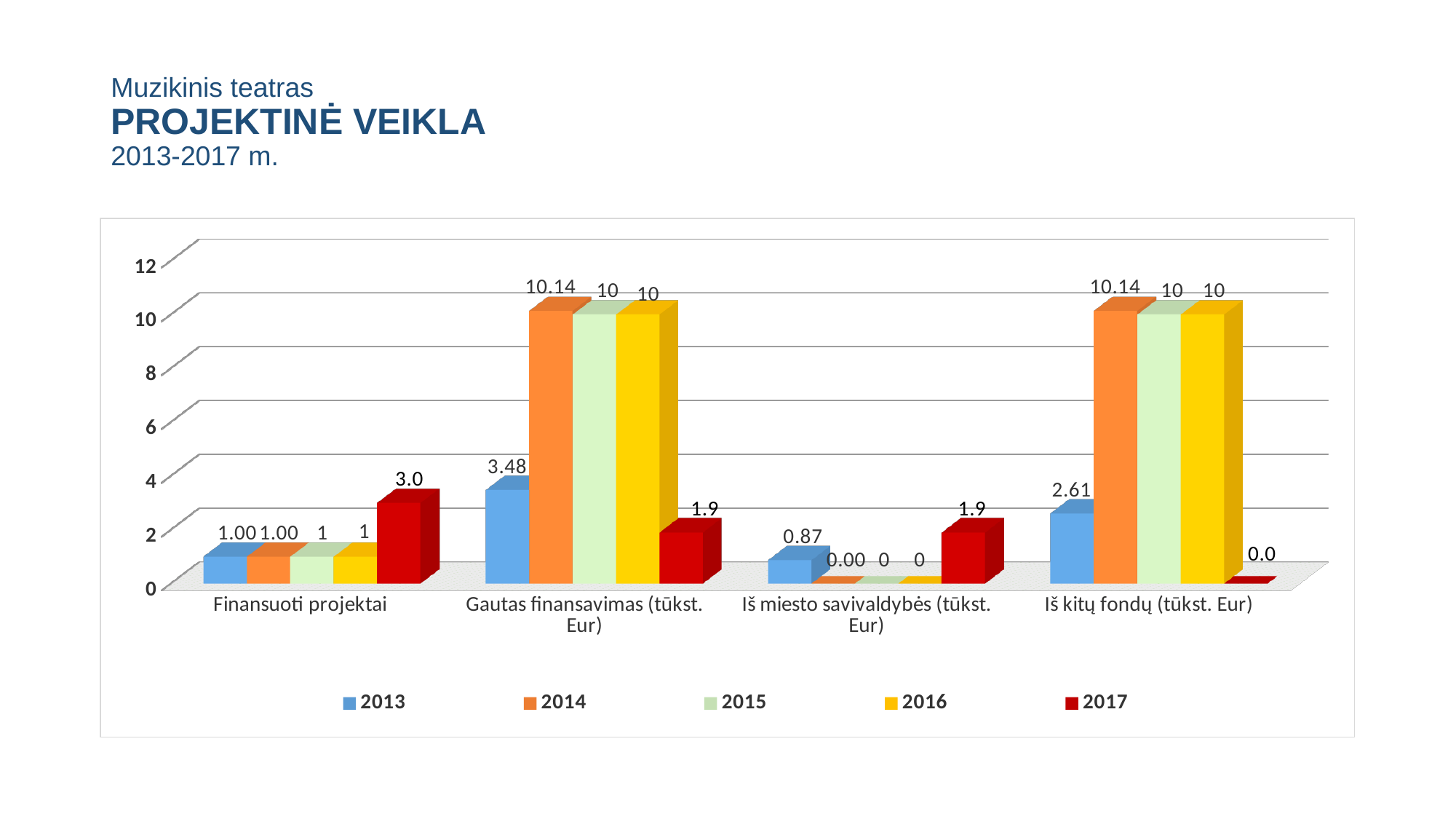
What is the value for 2014 in the Gautas finansavimas (tūkst. Eur) category? 10.14 What kind of chart is shown on the slide? Bar chart What is the difference between the 2014 and 2013 values in the Gautas finansavimas (tūkst. Eur) category? 6.66 How many series does the legend list? 5 Which year has the highest value in the Finansuoti projektai category? 2017 What is the value for 2013 in the Iš miesto savivaldybės (tūkst. Eur) category? 0.87 What is the value for 2017 in the Finansuoti projektai category? 3.0 Which year has the lowest value in the Gautas finansavimas (tūkst. Eur) category? 2017 Which years are listed in the legend? 2013, 2014, 2015, 2016, 2017 What is the value for 2013 in the Iš kitų fondų (tūkst. Eur) category? 2.61 How many categories are shown on the x axis? 4 Which is larger in the Iš kitų fondų (tūkst. Eur) category: the 2013 value or the 2017 value? 2013